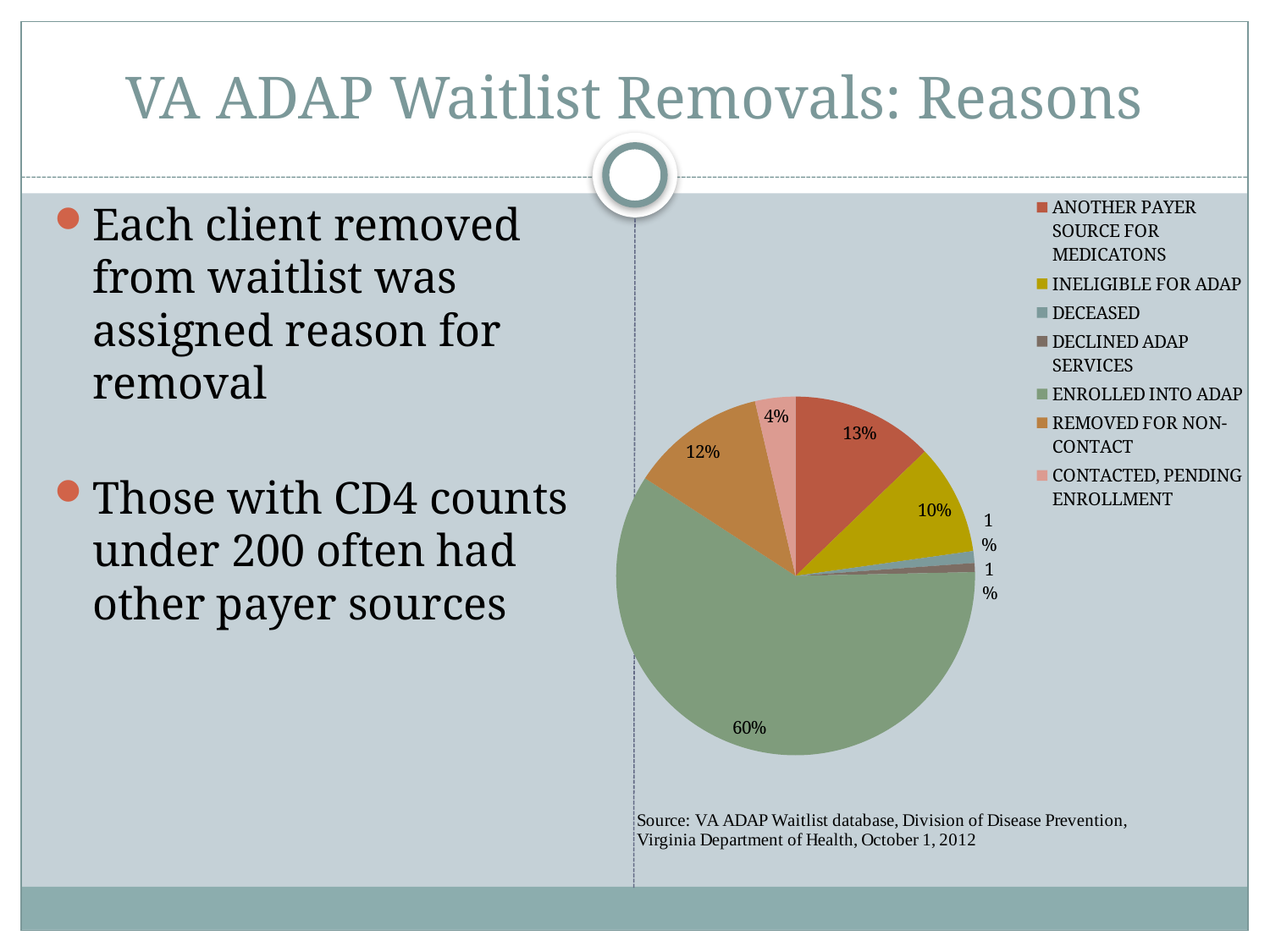
What kind of chart is shown on the slide? Pie chart What share of the pie is labelled for ENROLLED INTO ADAP? 60% What percentage is shown for CONTACTED, PENDING ENROLLMENT? 4% What is the combined share of the ANOTHER PAYER SOURCE FOR MEDICATONS and REMOVED FOR NON-CONTACT slices? 25% What is the difference between the ANOTHER PAYER SOURCE FOR MEDICATONS slice and the INELIGIBLE FOR ADAP slice? 3% Which is larger, the REMOVED FOR NON-CONTACT slice or the CONTACTED, PENDING ENROLLMENT slice? REMOVED FOR NON-CONTACT Which reason accounts for the largest slice of the pie? ENROLLED INTO ADAP What percentage is shown for ANOTHER PAYER SOURCE FOR MEDICATONS? 13% What is the title of the slide containing the pie chart? VA ADAP Waitlist Removals: Reasons What percentage is shown for REMOVED FOR NON-CONTACT? 12% What percentage is shown for INELIGIBLE FOR ADAP? 10% How many categories does the legend list? 7